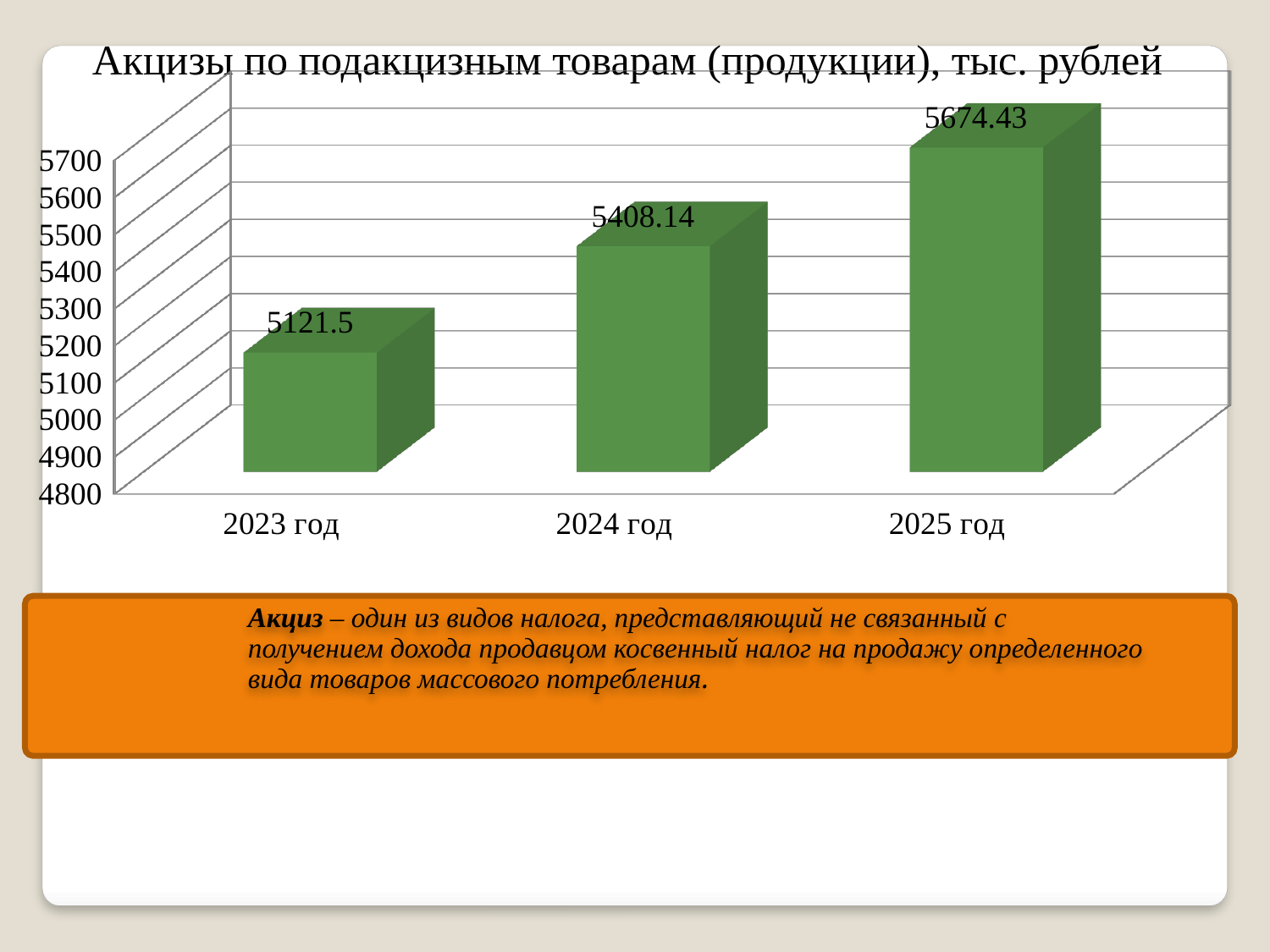
What is the difference between the values for 2025 год and 2024 год? 266.29 What is the value for 2025 год? 5674.43 What kind of chart is shown on the slide? bar chart What is the difference between the values for 2024 год and 2023 год? 286.64 Which year has the highest value? 2025 год What is the value for 2024 год? 5408.14 Do the values rise or fall from 2023 год to 2025 год? rise Which year has the lowest value? 2023 год Which is larger, the value for 2024 год or the value for 2025 год? 2025 год Is the value for 2023 год greater or less than 5200? less How many years are shown on the chart? 3 What is the value for 2023 год? 5121.5